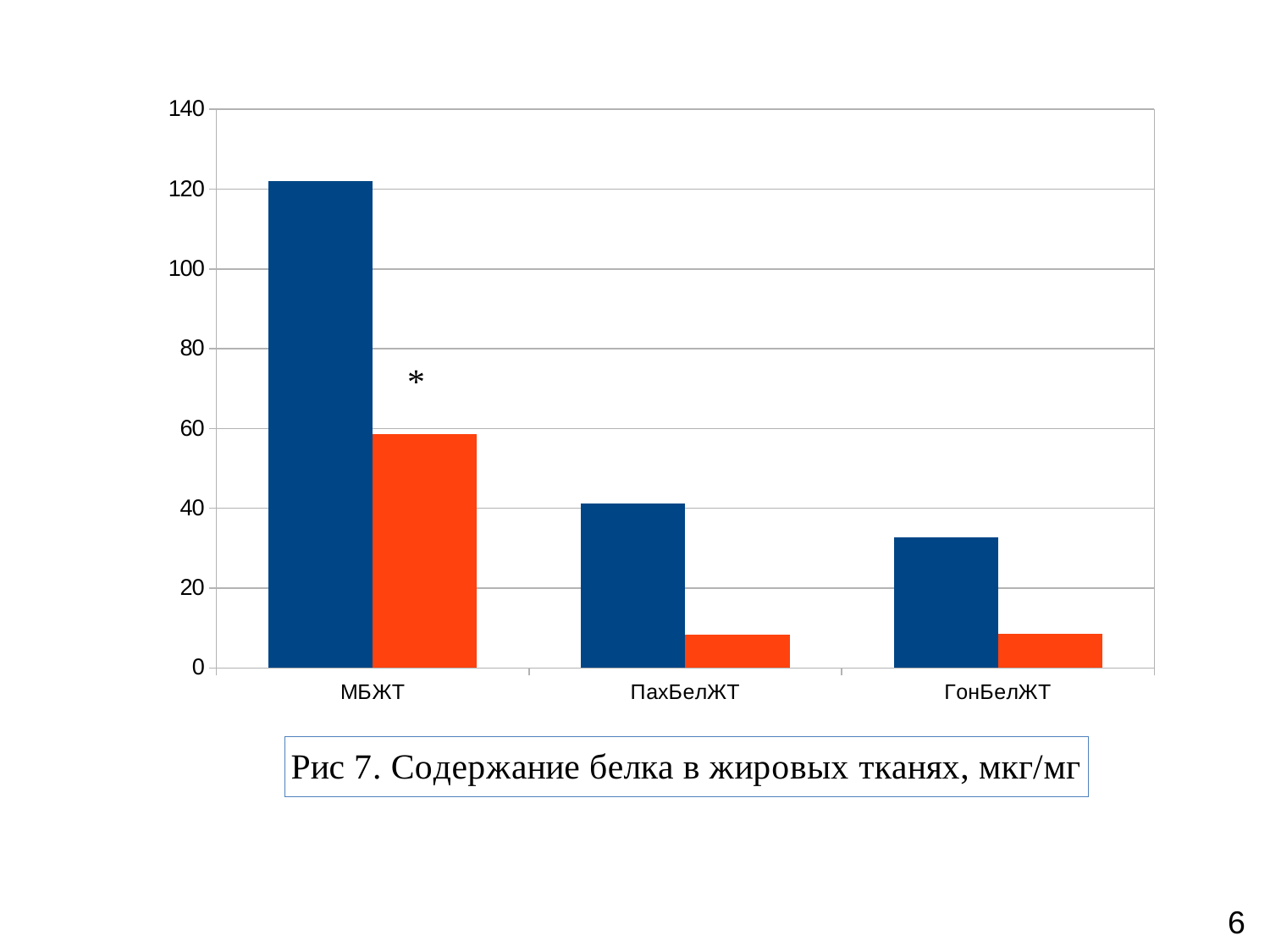
Which category has the tallest blue bar? МБЖТ How many categories are shown on the x axis? 3 Is the orange bar for ПахБелЖТ greater or less than 20? less Is the blue bar for МБЖТ greater or less than 100? greater Do the blue bars rise or fall from left to right across the categories? fall Which category has the shortest blue bar? ГонБелЖТ What is the title of the chart (the caption below it)? Рис 7. Содержание белка в жировых тканях, мкг/мг Which blue bar is larger, ПахБелЖТ or ГонБелЖТ? ПахБелЖТ Is the blue bar for ГонБелЖТ greater or less than 40? less What kind of chart is shown on the slide? bar chart For МБЖТ, which bar is larger, the blue one or the orange one? the blue one